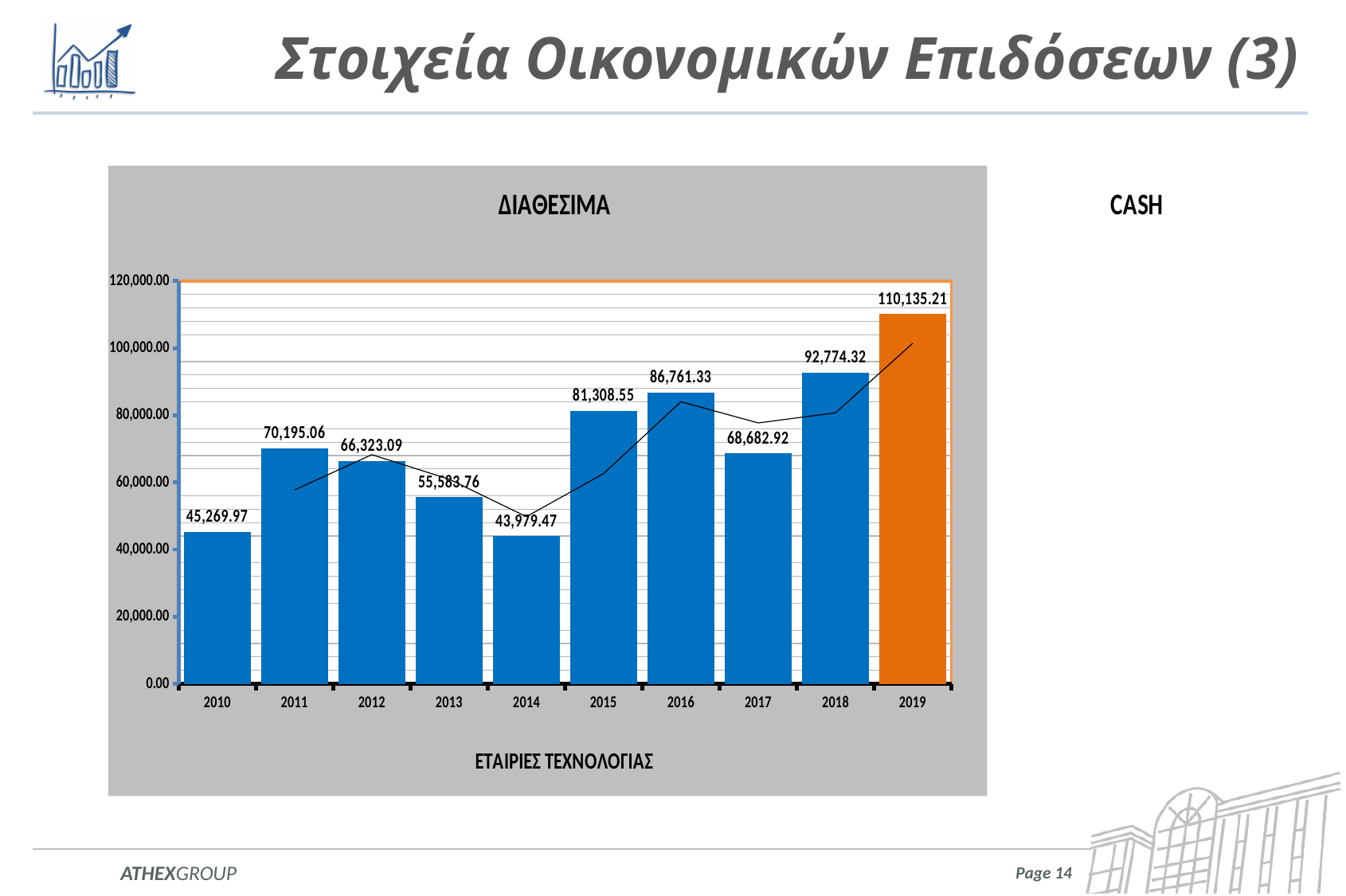
What is the value for 2014 in the ΔΙΑΘΕΣΙΜΑ chart? 43,979.47 In the ΔΙΑΘΕΣΙΜΑ chart, is the value for 2018 greater or less than 100,000.00? less What kind of chart is the ΔΙΑΘΕΣΙΜΑ chart? bar chart How many years are shown on the x axis of the ΔΙΑΘΕΣΙΜΑ chart? 10 What is the x-axis label shown below the ΔΙΑΘΕΣΙΜΑ chart? ΕΤΑΙΡΙΕΣ ΤΕΧΝΟΛΟΓΙΑΣ What is the difference between the 2011 and 2010 values in the ΔΙΑΘΕΣΙΜΑ chart? 24,925.09 What is the value for 2019 in the ΔΙΑΘΕΣΙΜΑ chart? 110,135.21 In the ΔΙΑΘΕΣΙΜΑ chart, which is larger, the value for 2015 or the value for 2017? 2015 What is the difference between the 2019 and 2018 values in the ΔΙΑΘΕΣΙΜΑ chart? 17,360.89 What is the value for 2016 in the ΔΙΑΘΕΣΙΜΑ chart? 86,761.33 Which year has the lowest value in the ΔΙΑΘΕΣΙΜΑ chart? 2014 Which year has the highest value in the ΔΙΑΘΕΣΙΜΑ chart? 2019